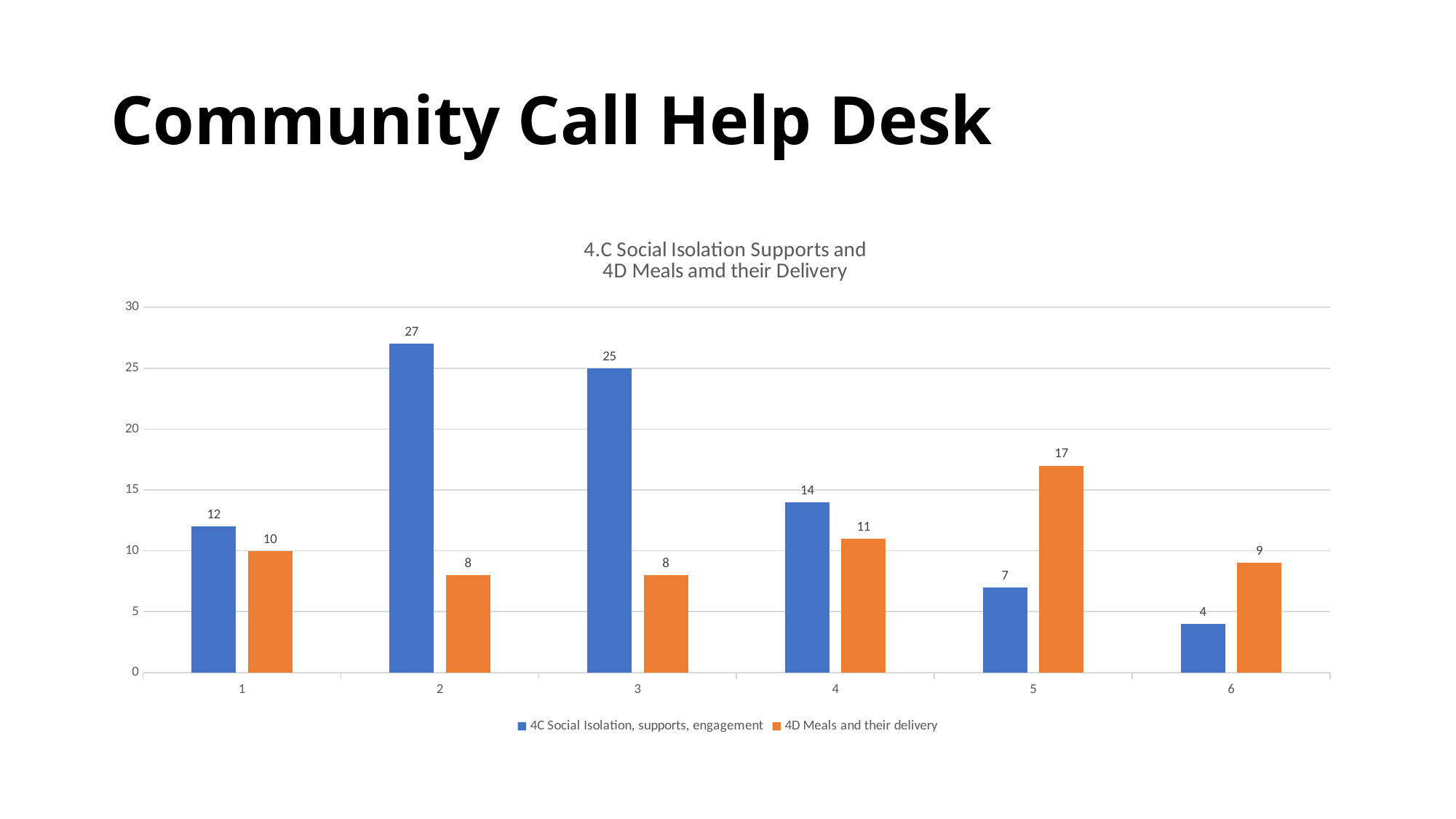
What kind of chart is shown on the slide? bar chart How many categories are shown on the x axis? 6 For category 5, which series has the larger value: '4C Social Isolation, supports, engagement' or '4D Meals and their delivery'? 4D Meals and their delivery Which category has the lowest value in the '4D Meals and their delivery' series? 2 and 3 Is the value for category 4 in the '4C Social Isolation, supports, engagement' series greater or less than 10? greater Which category has the highest value in the '4C Social Isolation, supports, engagement' series? 2 How many series does the legend list? 2 What is the title of the chart? 4.C Social Isolation Supports and 4D Meals amd their Delivery What is the difference between the '4C Social Isolation, supports, engagement' value and the '4D Meals and their delivery' value for category 3? 17 What is the value for category 6 in the '4C Social Isolation, supports, engagement' series? 4 What is the value for category 5 in the '4D Meals and their delivery' series? 17 What is the value for category 2 in the '4C Social Isolation, supports, engagement' series? 27